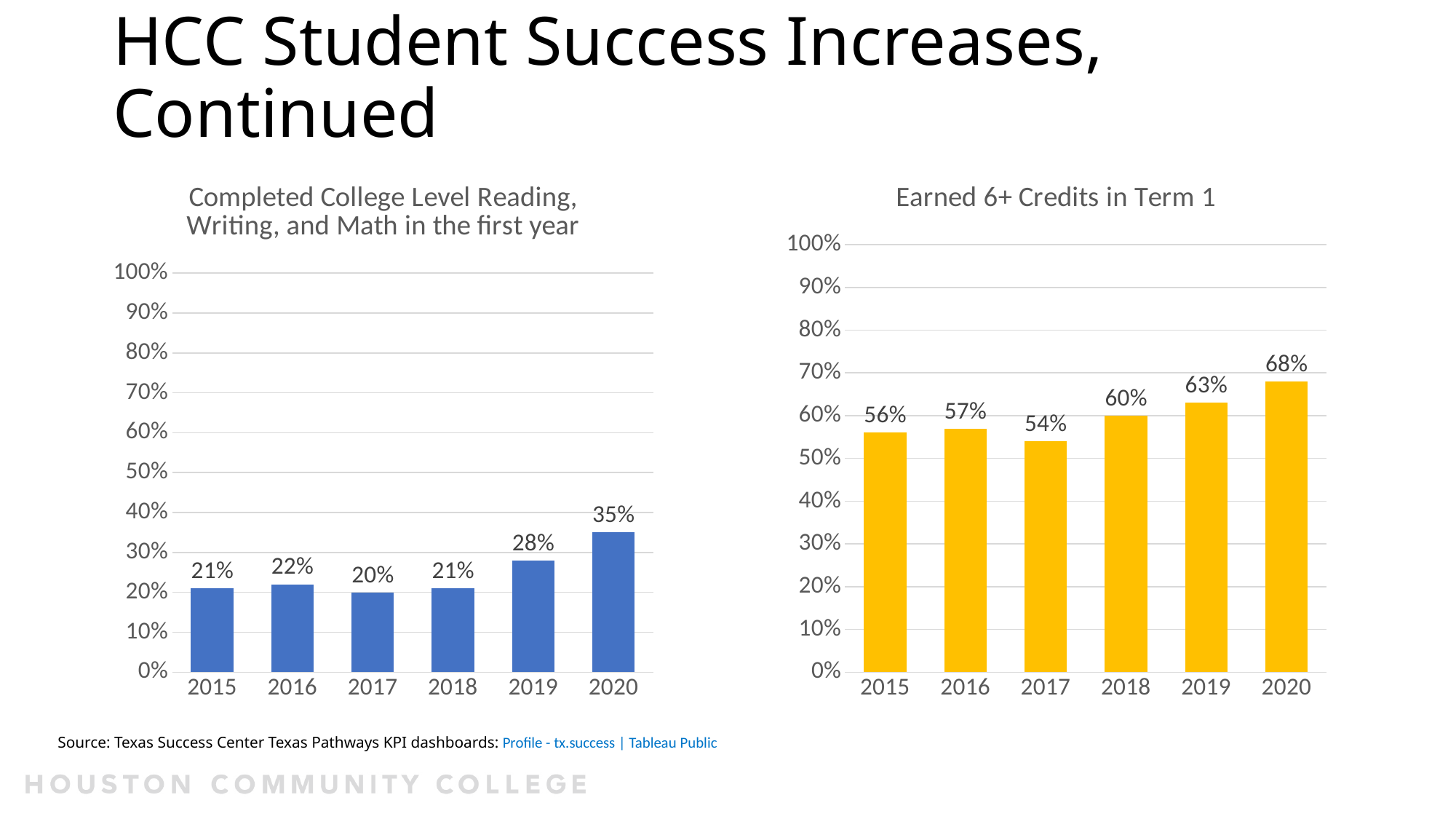
In the 'Completed College Level Reading, Writing, and Math in the first year' chart, what is the value for 2020? 35% In the 'Earned 6+ Credits in Term 1' chart, what is the difference between the 2020 and 2015 values? 12% In the 'Completed College Level Reading, Writing, and Math in the first year' chart, what is the difference between the 2019 and 2018 values? 7% In the 'Earned 6+ Credits in Term 1' chart, do the values rise or fall from 2017 to 2020? Rise In the 'Completed College Level Reading, Writing, and Math in the first year' chart, which year has the lowest value? 2017 What kind of chart is the 'Completed College Level Reading, Writing, and Math in the first year' chart? Bar chart In the 'Earned 6+ Credits in Term 1' chart, what is the value for 2017? 54% In the 'Completed College Level Reading, Writing, and Math in the first year' chart, is the value for 2020 greater or less than 30%? greater What colour are the bars in the 'Earned 6+ Credits in Term 1' chart? Yellow How many years are shown on the x axis of the 'Earned 6+ Credits in Term 1' chart? 6 In the 'Earned 6+ Credits in Term 1' chart, which year has the highest value? 2020 In the 'Earned 6+ Credits in Term 1' chart, which is larger, the value for 2018 or the value for 2016? 2018